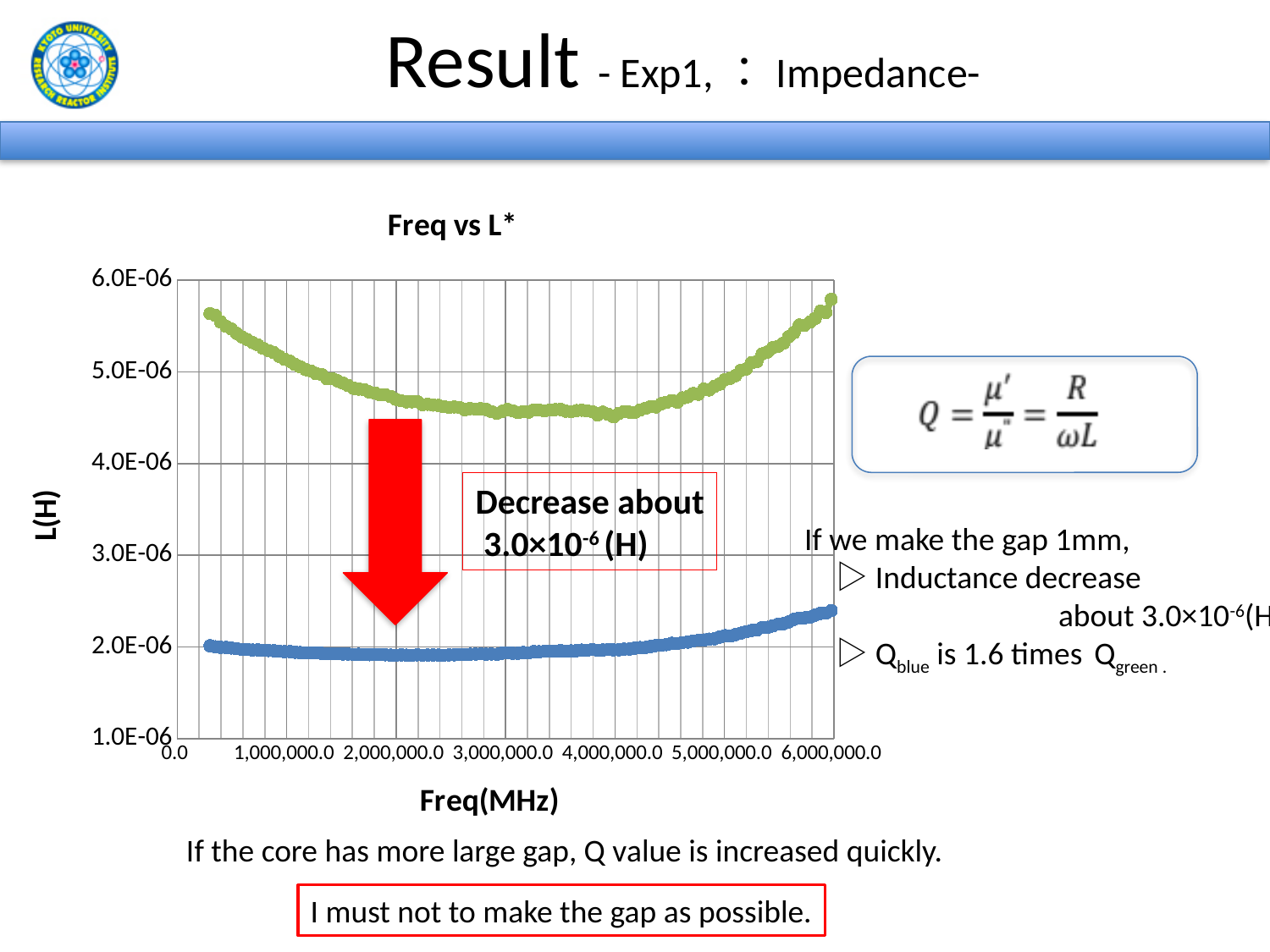
Which series has the higher inductance values across the frequency range, the green or the blue? Green How many data series are plotted on the chart? 2 Does the green series rise or fall as frequency increases from 4,000,000.0 to 6,000,000.0 MHz? rise Does the green series rise or fall as frequency increases from 0.0 to 3,000,000.0 MHz? fall What is the highest value shown on the vertical axis of the chart? 6.0E-06 Is the value of the green series at the lowest plotted frequency greater or less than 5.0E-06? greater What is the title of the chart? Freq vs L* What is the label of the vertical axis of the chart? L(H) Is the value of the blue series at the highest plotted frequency greater or less than 2.0E-06? greater Is the value of the blue series near 3,000,000.0 MHz greater or less than 3.0E-06? less What kind of chart is shown on the slide? Scatter (line) chart